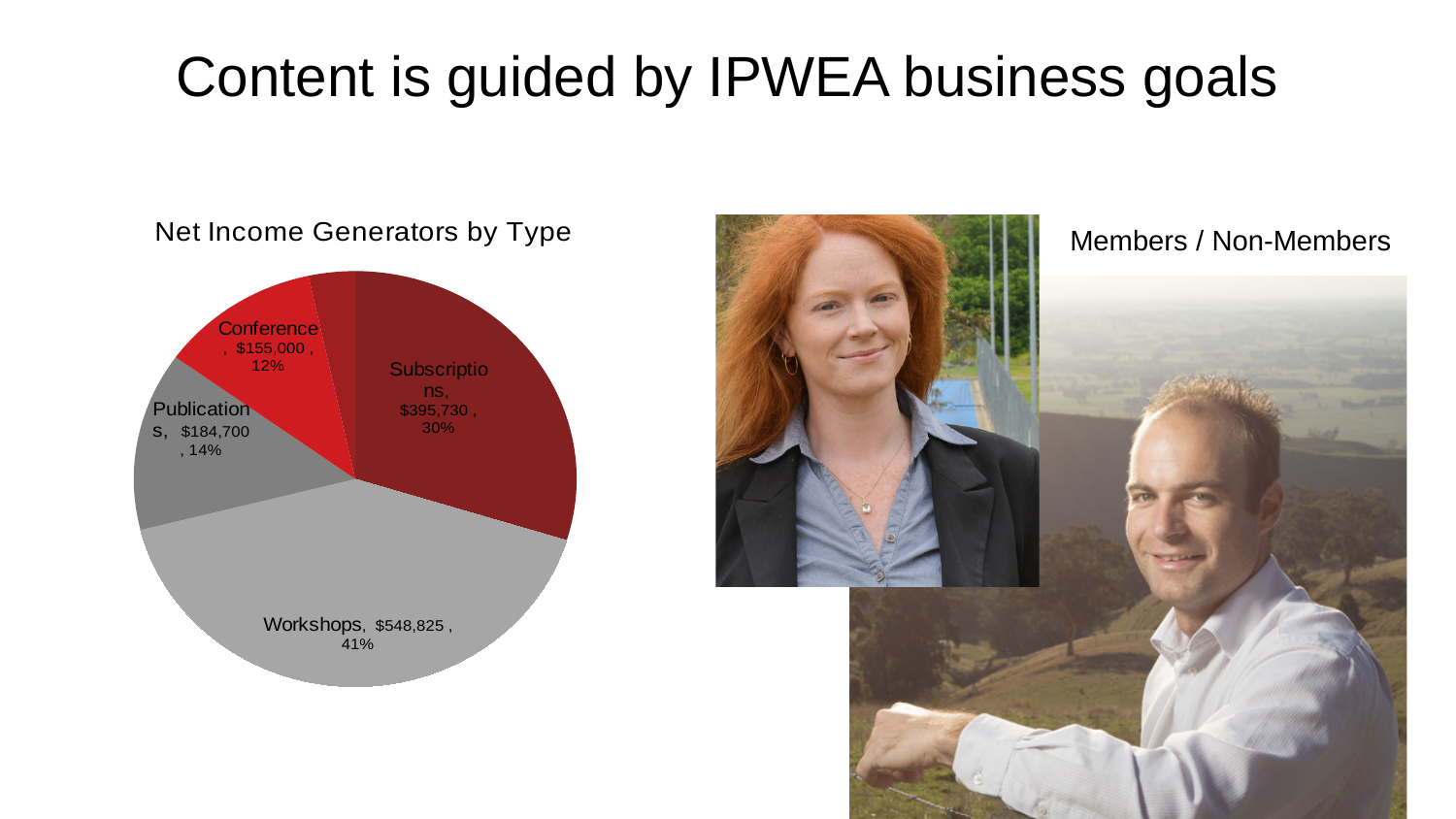
Which labeled category has the highest value? Workshops What is the value for Publications? $184,700 What share of the pie does Subscriptions represent? 30% What is the difference between the values for Workshops and Subscriptions? $153,095 Which labeled category has the lowest value? Conference What is the title of the chart? Net Income Generators by Type What type of chart is shown on the slide? pie chart What share of the pie does Workshops represent? 41% What is the value for Subscriptions? $395,730 What is the value for Workshops? $548,825 Which is larger, the value for Publications or the value for Conference? Publications What is the value for Conference? $155,000